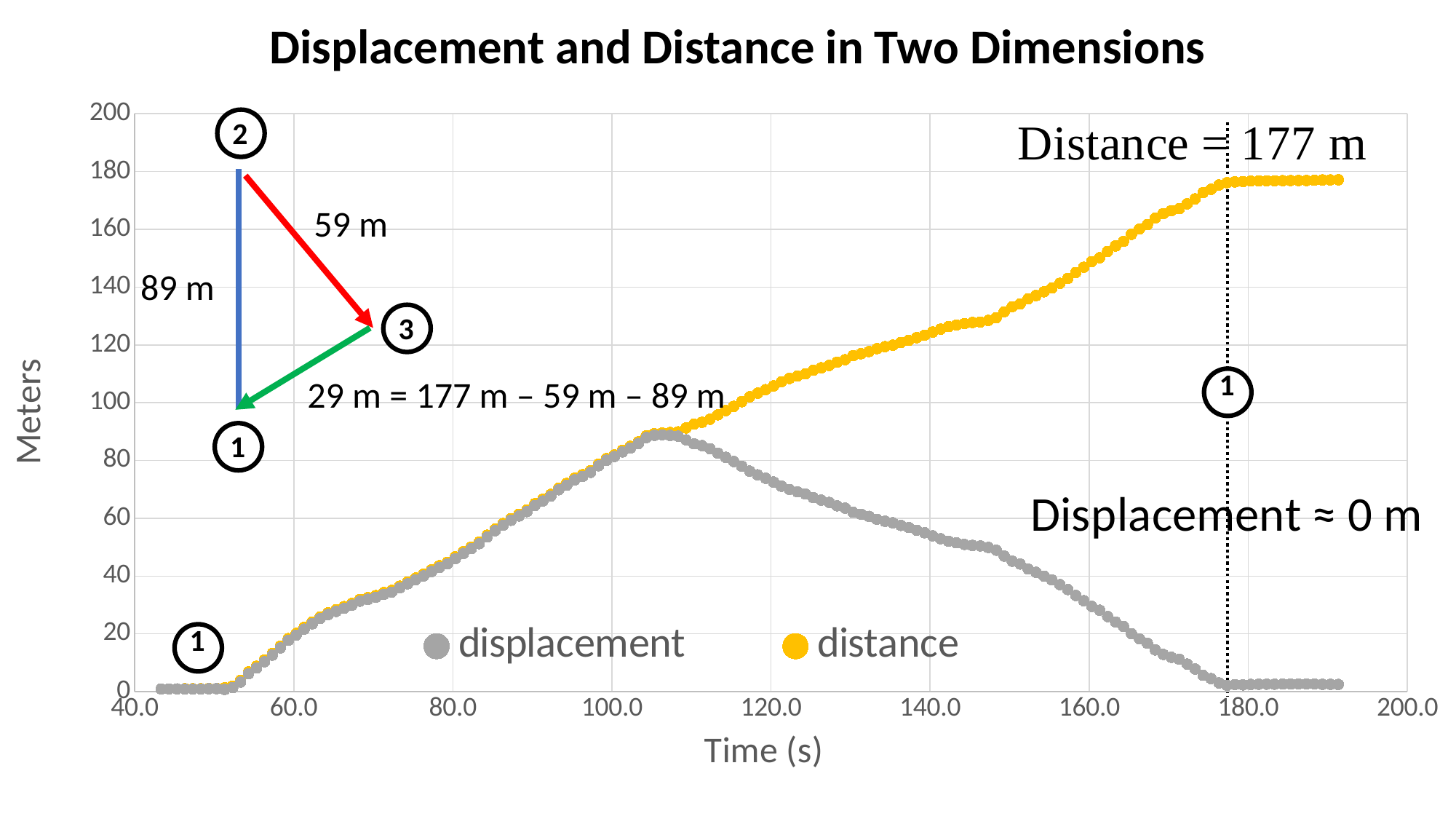
According to the annotation on the chart, what is the final value of the distance series? 177 m How many series does the legend list? 2 What is the label of the y axis? Meters Is the value of the displacement series at 160.0 s greater or less than 40? less Is the value of the distance series at 160.0 s greater or less than 140? greater At 140.0 s, which series has the larger value, displacement or distance? distance What is the title of the chart? Displacement and Distance in Two Dimensions In the triangle diagram, what length is labelled on the blue segment between points 1 and 2? 89 m Does the distance series rise or fall as time increases along the x axis? rise What are the two series named in the legend? displacement and distance What kind of chart is shown on the slide? scatter chart Is the value of the distance series at 120.0 s greater or less than 100? greater